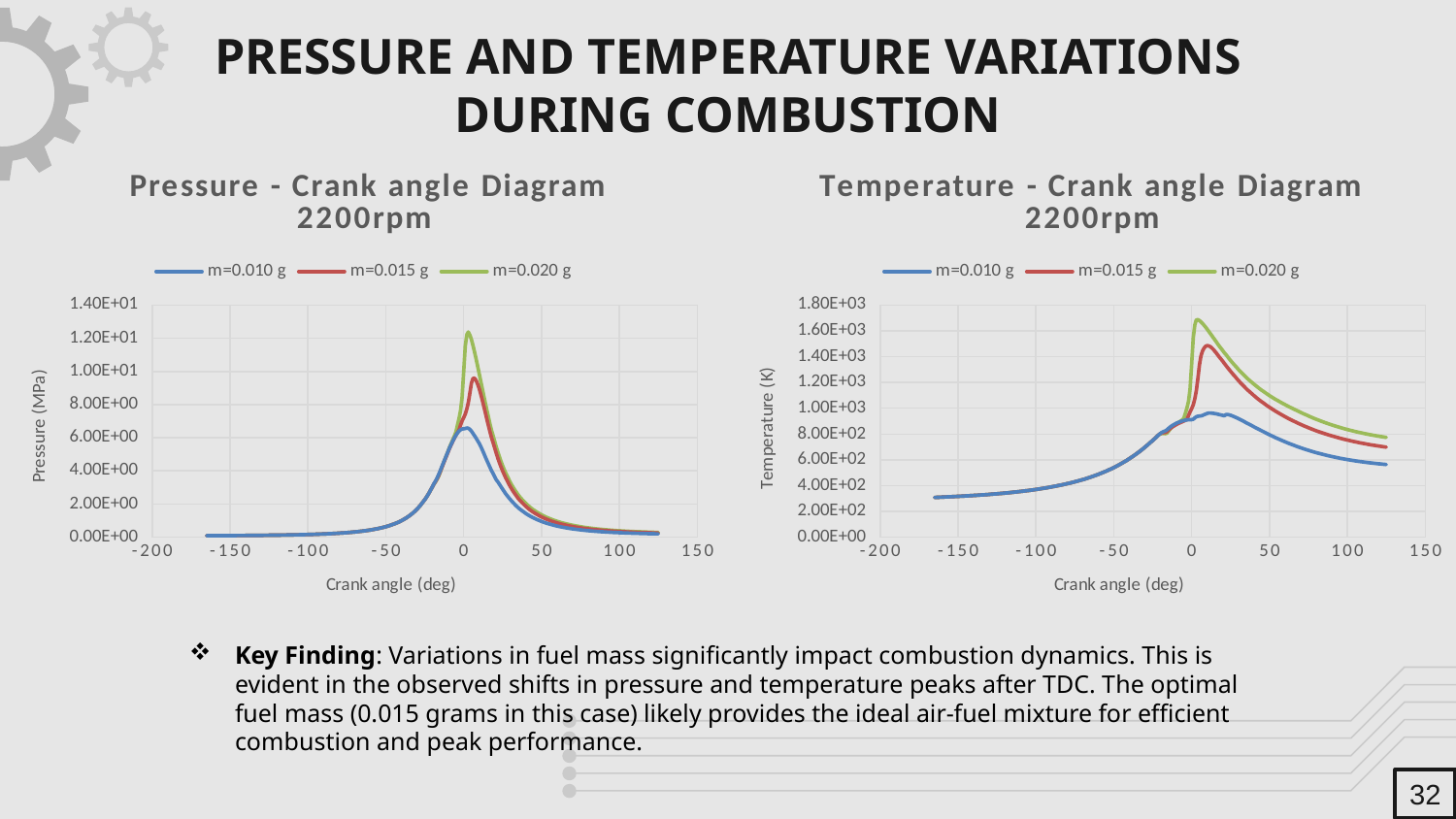
What is the y-axis title of the Temperature - Crank angle Diagram 2200rpm? Temperature (K) In the Temperature - Crank angle Diagram 2200rpm, does the temperature for m=0.010 g rise or fall as the crank angle goes from -150 to 0? Rise In the Pressure - Crank angle Diagram 2200rpm, which series reaches the highest peak pressure? m=0.020 g In the Temperature - Crank angle Diagram 2200rpm, is the peak temperature for m=0.010 g greater or less than 1.20E+03? less In the Pressure - Crank angle Diagram 2200rpm, is the peak pressure for m=0.010 g greater or less than 8.00E+00? less What kind of chart is the Pressure - Crank angle Diagram 2200rpm? Line chart In the Temperature - Crank angle Diagram 2200rpm, which series reaches the highest peak temperature? m=0.020 g In the Pressure - Crank angle Diagram 2200rpm, is the peak pressure for m=0.020 g greater or less than 1.00E+01? greater In the Pressure - Crank angle Diagram 2200rpm, which series has the lowest peak pressure? m=0.010 g In the Temperature - Crank angle Diagram 2200rpm, which series has the higher peak temperature, m=0.015 g or m=0.010 g? m=0.015 g How many series does the legend of the Temperature - Crank angle Diagram 2200rpm list? 3